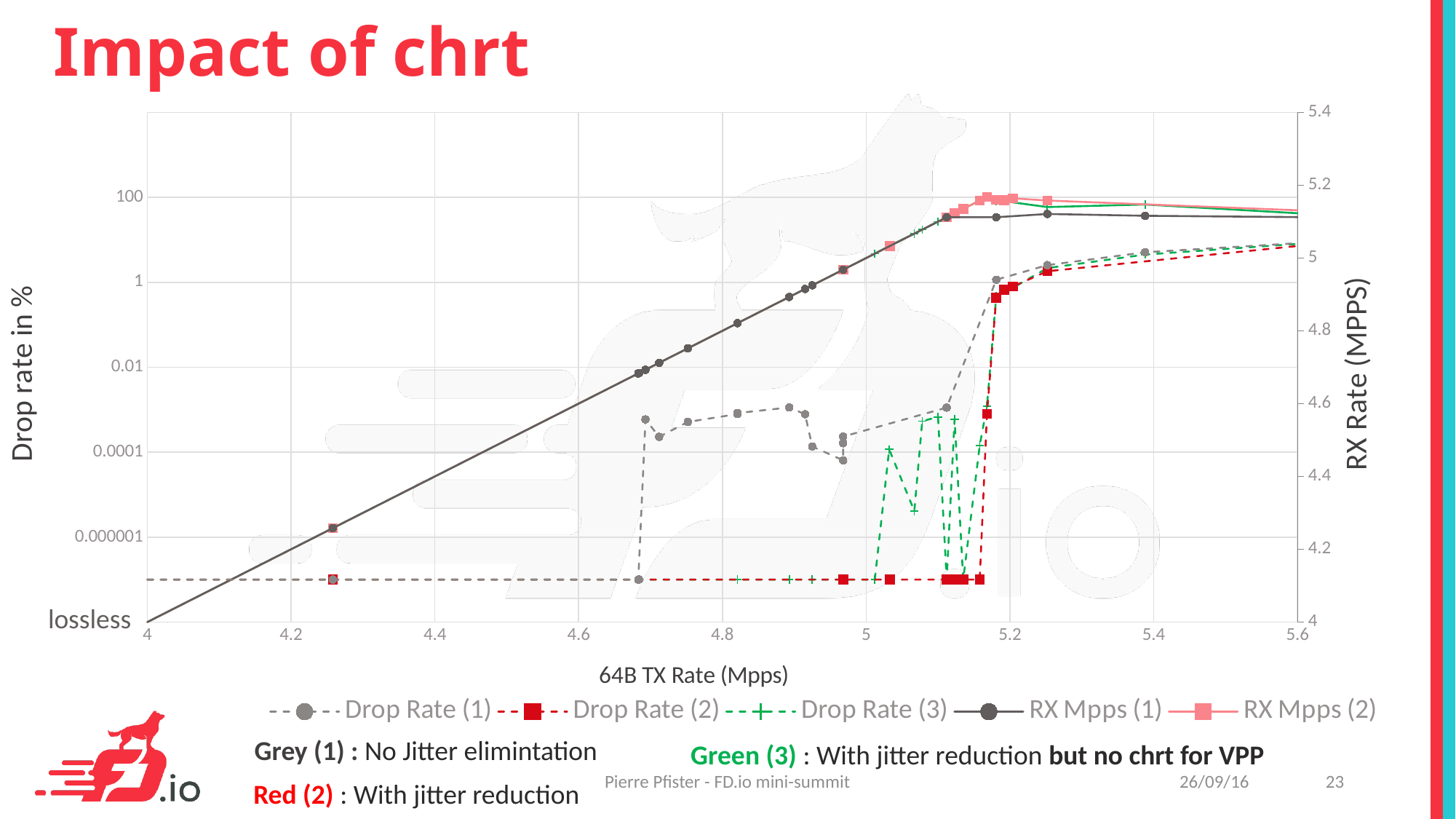
Is the value of Drop Rate (1) at a TX rate of 5.6 greater or less than 1%? greater Is the value of RX Mpps (2) at a TX rate of 5.6 greater or less than 5 MPPS? greater How many series does the chart legend list? 5 At a TX rate of 5.2, which series is higher, RX Mpps (1) or RX Mpps (2)? RX Mpps (2) Is the value of Drop Rate (1) at a TX rate of 4.8 greater or less than 0.01%? less What kind of chart is shown on the slide? line chart Does RX Mpps (1) rise or fall as the TX rate increases from 4 to 5.2? rise What is the label of the x axis of the chart? 64B TX Rate (Mpps) What is the title of the slide containing the chart? Impact of chrt